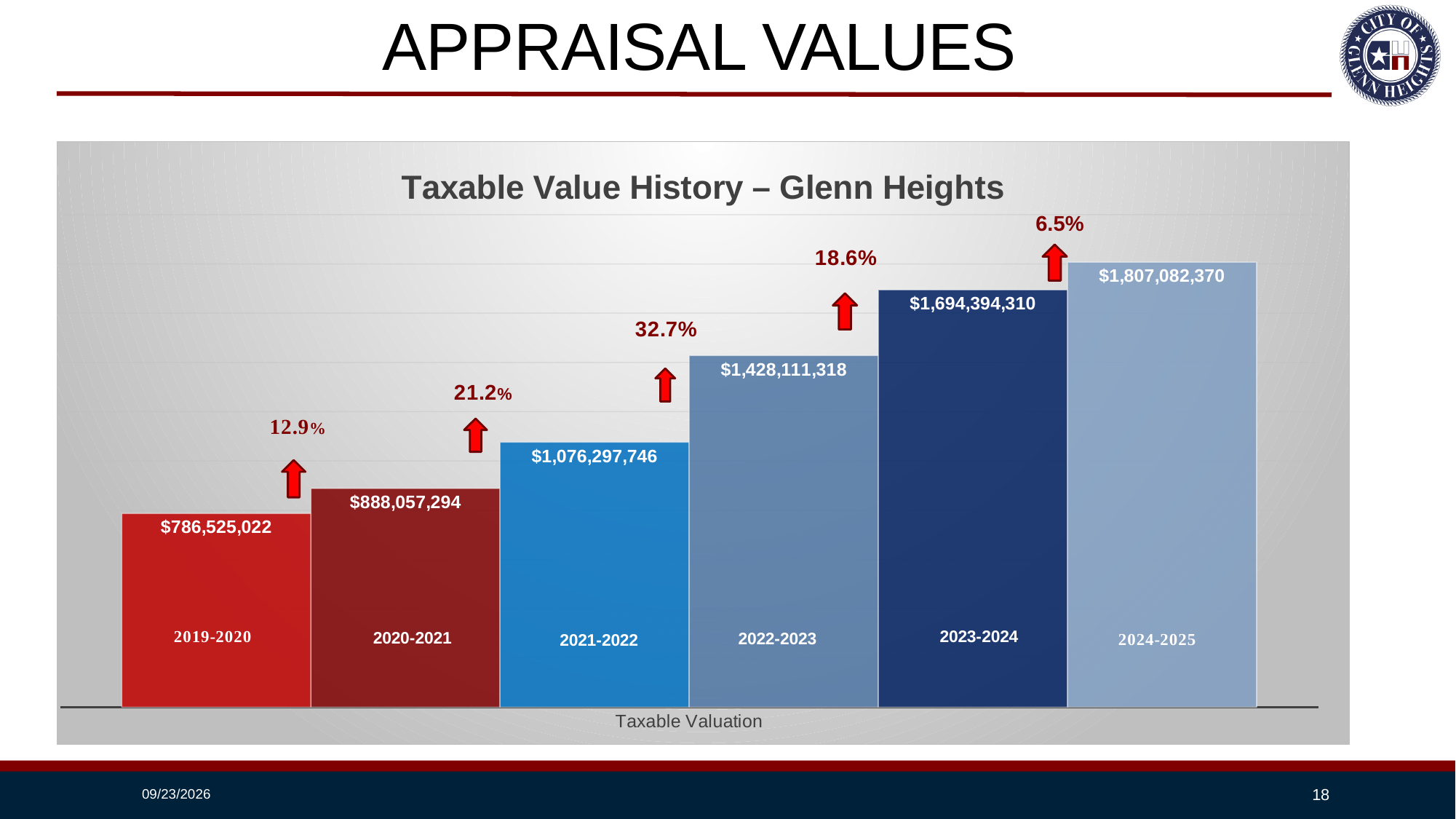
What kind of chart is shown on the slide? Bar chart What is the taxable value for 2024-2025? $1,807,082,370 How many years are shown in the chart? 6 What is the taxable value for 2022-2023? $1,428,111,318 Which is larger, the taxable value for 2021-2022 or for 2023-2024? 2023-2024 What is the taxable value for 2019-2020? $786,525,022 Do the taxable values rise or fall from 2019-2020 to 2024-2025? Rise What is the difference in taxable value between 2024-2025 and 2023-2024? $112,688,060 Which year has the highest taxable value? 2024-2025 Which year has the lowest taxable value? 2019-2020 What is the difference in taxable value between 2020-2021 and 2019-2020? $101,532,272 What percentage increase is shown between 2021-2022 and 2022-2023? 32.7%